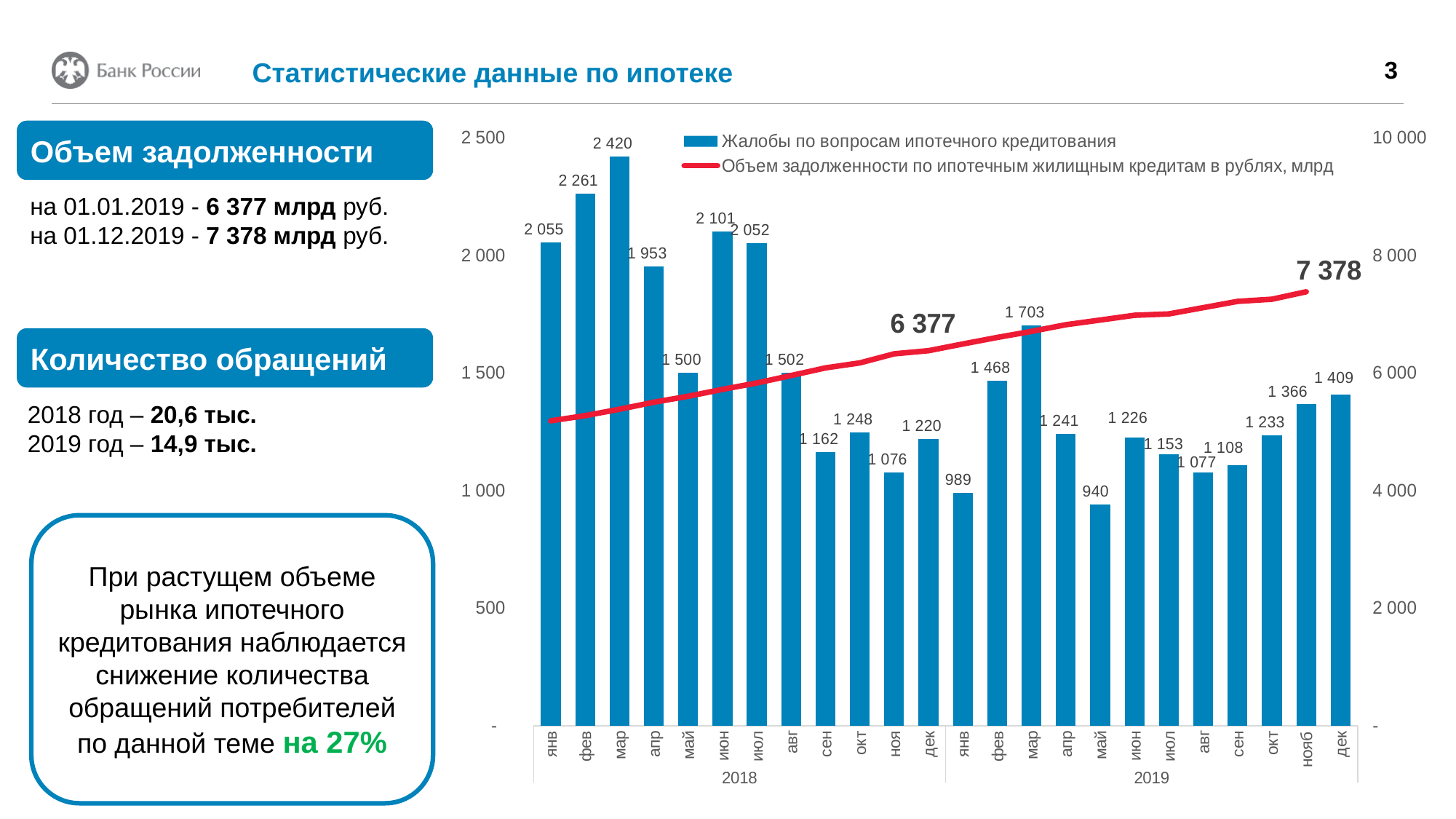
How many series does the legend list? 2 Which month has the highest number of complaints on the chart? мар 2018 How many monthly bars are plotted on the chart? 24 What is the number of complaints for май 2019? 940 Which has more complaints: фев 2019 or мар 2019? мар 2019 What type of chart is used for the complaints series? bar chart What is the number of complaints (Жалобы по вопросам ипотечного кредитования) for мар 2018? 2 420 What colour are the bars for complaints on the chart? blue What value is labelled on the red debt line at the end of 2019? 7 378 Which month has the lowest number of complaints on the chart? май 2019 What is the difference in complaints between янв 2018 and янв 2019? 1 066 Does the red line (Объем задолженности по ипотечным жилищным кредитам) rise or fall from left to right? rise